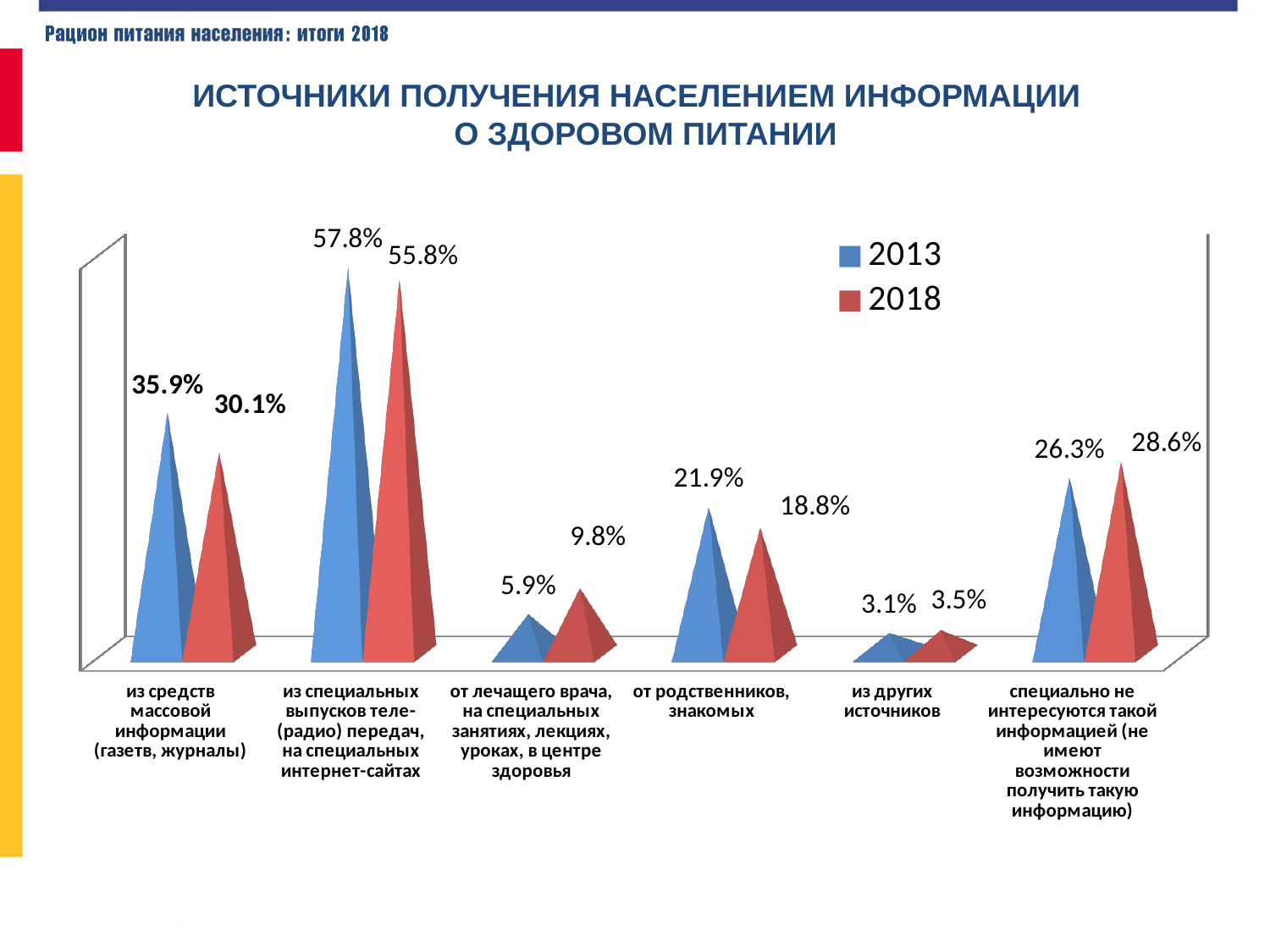
Which category has the lowest value for 2018? из других источников What is the 2018 value for «из средств массовой информации (газетв, журналы)»? 30.1% What is the difference between the 2013 and 2018 values for «из средств массовой информации (газетв, журналы)»? 5.8% What is the 2013 value for «от родственников, знакомых»? 21.9% For «от родственников, знакомых», which year has the larger value, 2013 or 2018? 2013 How many series does the legend list? 2 How many categories are shown on the x axis of the chart? 6 What is the difference between the 2018 and 2013 values for «специально не интересуются такой информацией»? 2.3% What is the 2018 value for «от лечащего врача, на специальных занятиях, лекциях, уроках, в центре здоровья»? 9.8% For «от лечащего врача, на специальных занятиях, лекциях, уроках, в центре здоровья», which year has the larger value, 2013 or 2018? 2018 What kind of chart is shown on the slide? bar chart Which category has the highest value for 2013? из специальных выпусков теле-(радио) передач, на специальных интернет-сайтах